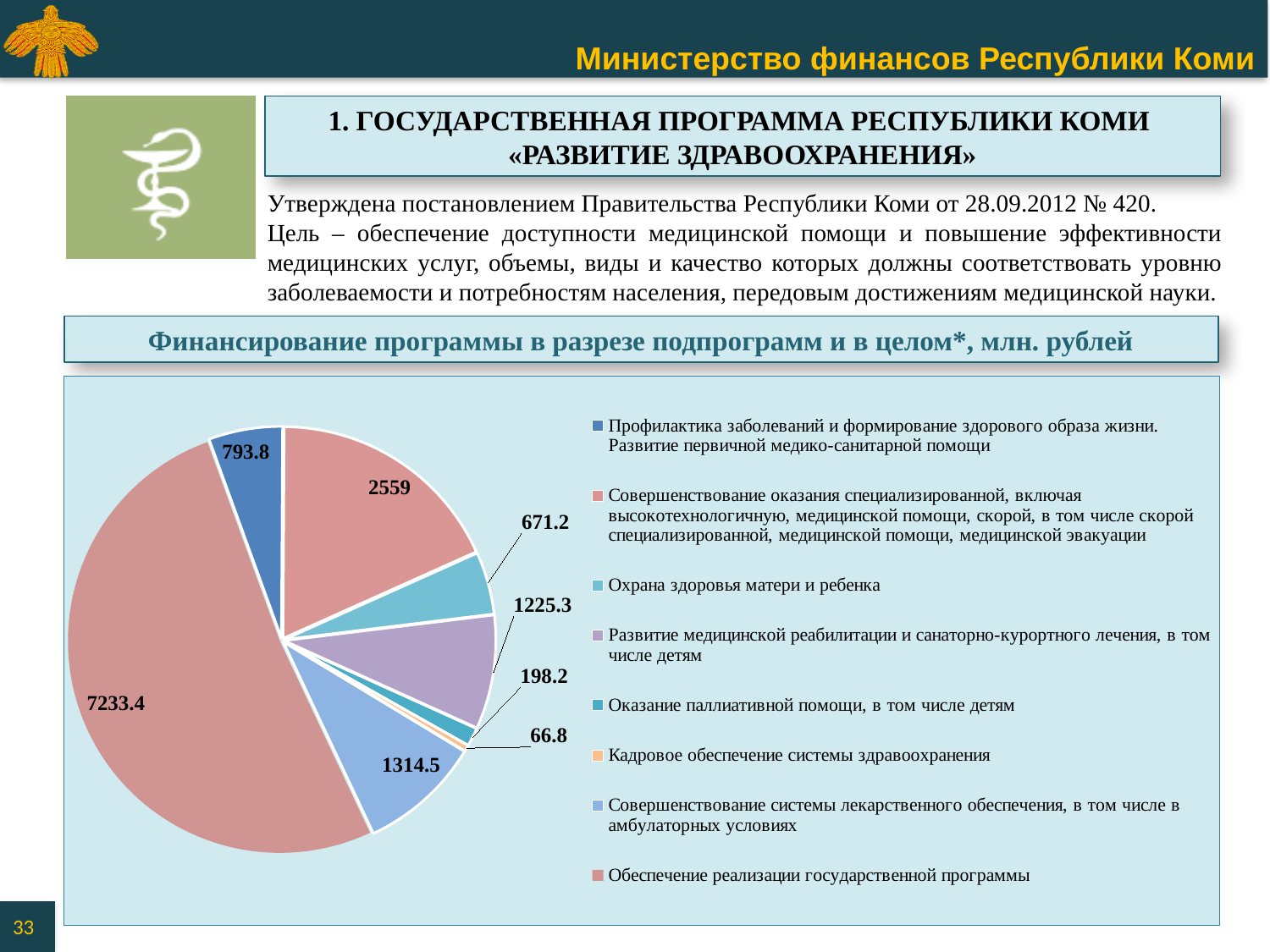
Which subprogram has the largest slice of the pie? Обеспечение реализации государственной программы What type of chart is shown on the slide? pie chart Which is larger: the value for «Охрана здоровья матери и ребенка» or the value for «Оказание паллиативной помощи, в том числе детям»? Охрана здоровья матери и ребенка What is the difference between the value for «Совершенствование системы лекарственного обеспечения, в том числе в амбулаторных условиях» (1314.5) and «Профилактика заболеваний и формирование здорового образа жизни. Развитие первичной медико-санитарной помощи» (793.8)? 520.7 What is the value for «Оказание паллиативной помощи, в том числе детям»? 198.2 What is the value for «Кадровое обеспечение системы здравоохранения»? 66.8 What is the value for «Охрана здоровья матери и ребенка»? 671.2 Which subprogram has the smallest slice of the pie? Кадровое обеспечение системы здравоохранения How many entries does the legend list? 8 What is the value for «Развитие медицинской реабилитации и санаторно-курортного лечения, в том числе детям»? 1225.3 What is the title of the chart section, as shown above the pie chart? Финансирование программы в разрезе подпрограмм и в целом*, млн. рублей How many slices does the pie chart have? 8